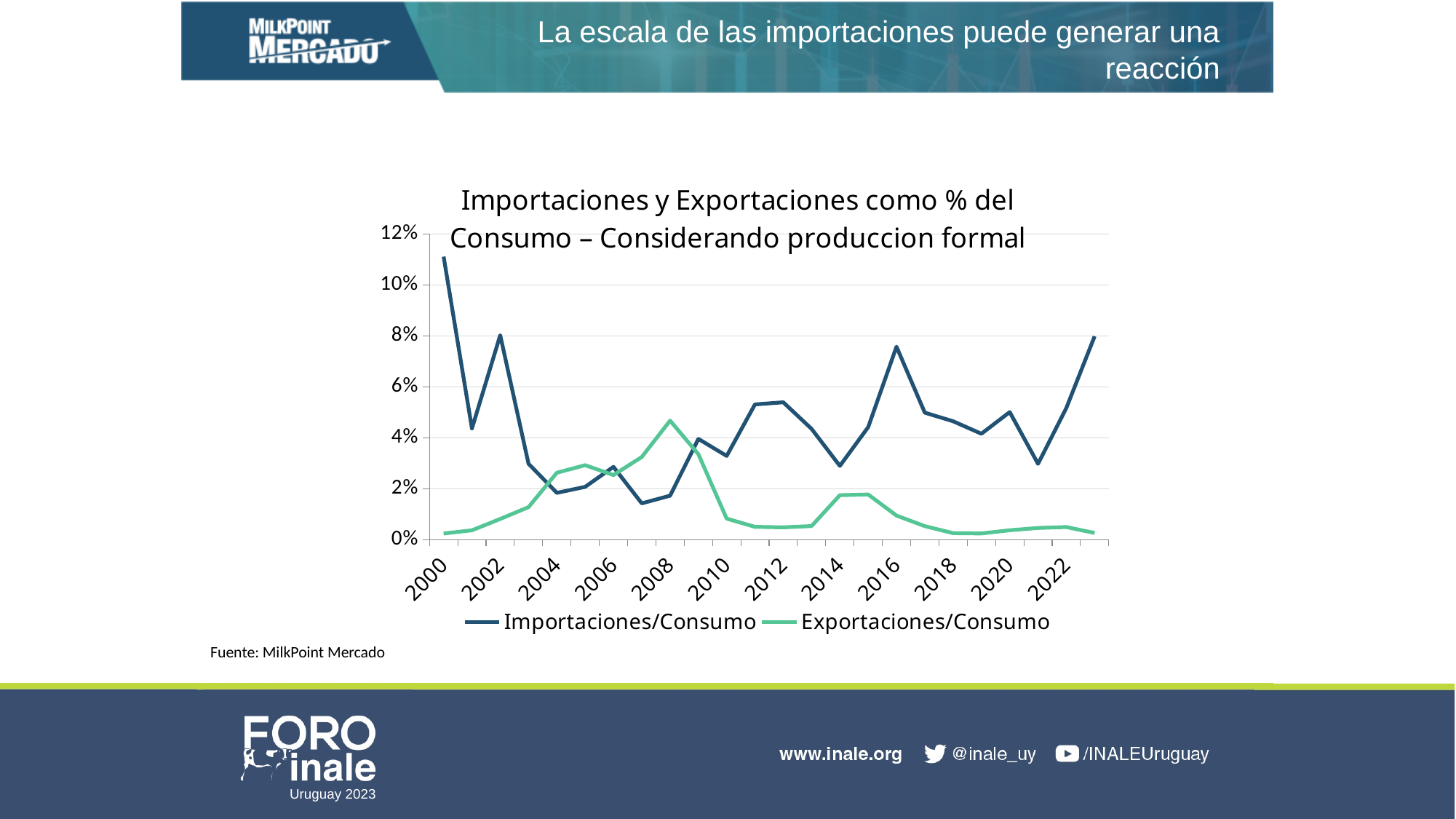
How many series does the legend list? 2 What kind of chart is shown on the slide? line chart Is the value for Importaciones/Consumo in 2000 greater or less than 10%? greater Is the value for Importaciones/Consumo in 2016 greater or less than 6%? greater In 2008, which series has the higher value, Importaciones/Consumo or Exportaciones/Consumo? Exportaciones/Consumo Is the value for Exportaciones/Consumo in 2010 greater or less than 2%? less Does the Exportaciones/Consumo series rise or fall between 2008 and 2010? fall What is the title of the chart? Importaciones y Exportaciones como % del Consumo – Considerando produccion formal In which year does the Importaciones/Consumo series reach its highest value? 2000 In which year does the Exportaciones/Consumo series reach its highest value? 2008 What are the two series named in the legend? Importaciones/Consumo and Exportaciones/Consumo